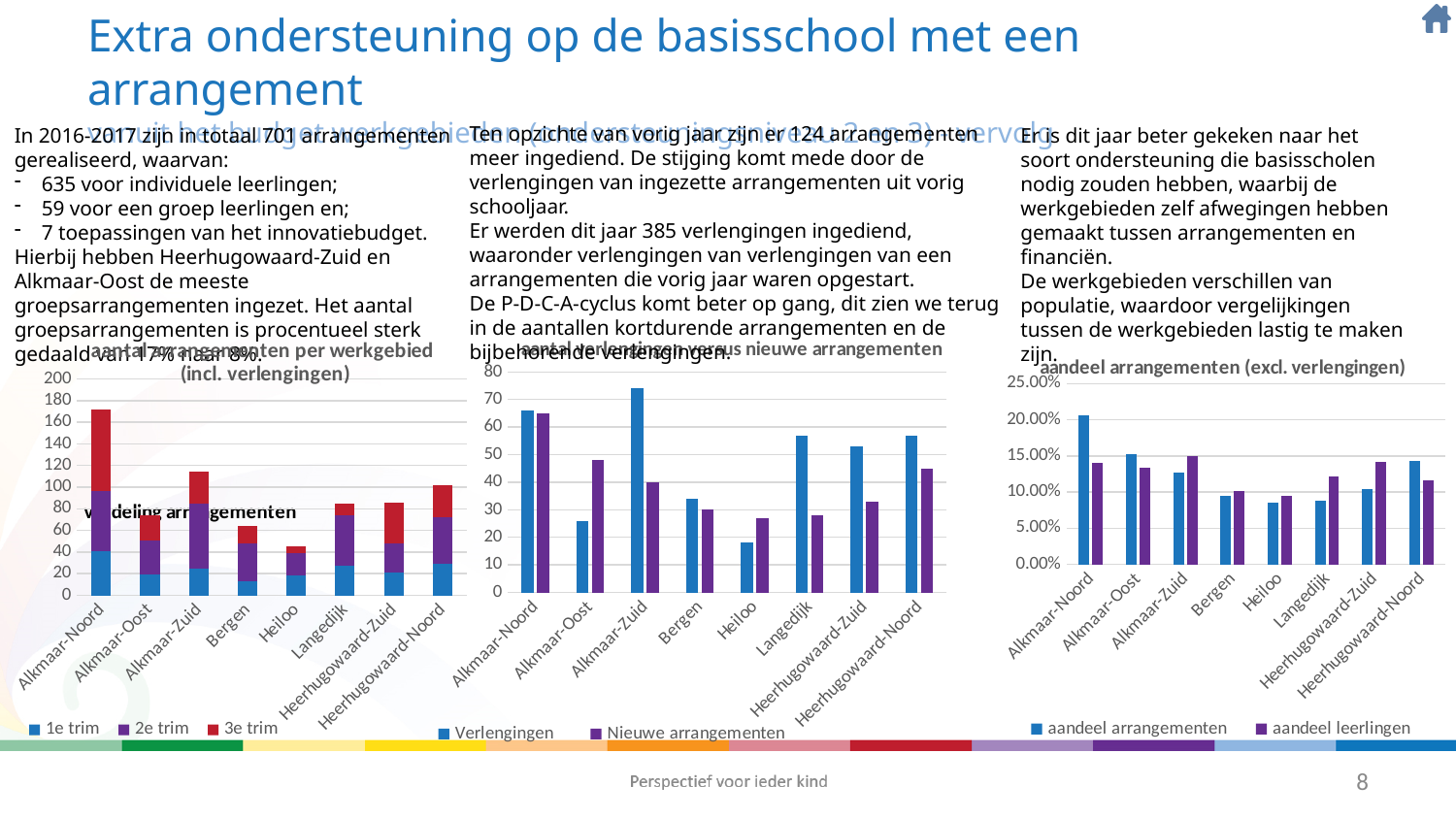
In the chart titled 'aantal arrangementen per werkgebied (incl. verlengingen)', which werkgebied has the tallest stacked bar? Alkmaar-Noord In the chart titled 'aantal verlengingen versus nieuwe arrangementen', how many werkgebieden are shown on the x axis? 8 In the chart titled 'aantal verlengingen versus nieuwe arrangementen', which werkgebied has the lowest value for Verlengingen? Heiloo In the chart titled 'aandeel arrangementen (excl. verlengingen)', is the 'aandeel arrangementen' for Alkmaar-Noord greater or less than 20.00%? greater In the chart titled 'aantal arrangementen per werkgebied (incl. verlengingen)', what kind of chart is shown? stacked bar chart In the chart titled 'aandeel arrangementen (excl. verlengingen)', which werkgebied has the highest 'aandeel arrangementen'? Alkmaar-Noord In the chart titled 'aandeel arrangementen (excl. verlengingen)', what are the two series listed in the legend? aandeel arrangementen and aandeel leerlingen In the chart titled 'aantal arrangementen per werkgebied (incl. verlengingen)', how many series does the legend list? 3 In the chart titled 'aantal verlengingen versus nieuwe arrangementen', which werkgebied has the highest value for Verlengingen? Alkmaar-Zuid In the chart titled 'aantal arrangementen per werkgebied (incl. verlengingen)', is the total bar for Alkmaar-Noord greater or less than 160? greater In the chart titled 'aantal arrangementen per werkgebied (incl. verlengingen)', which werkgebied has the shortest stacked bar? Heiloo In the chart titled 'aantal verlengingen versus nieuwe arrangementen', for Alkmaar-Oost, which is larger: Verlengingen or Nieuwe arrangementen? Nieuwe arrangementen